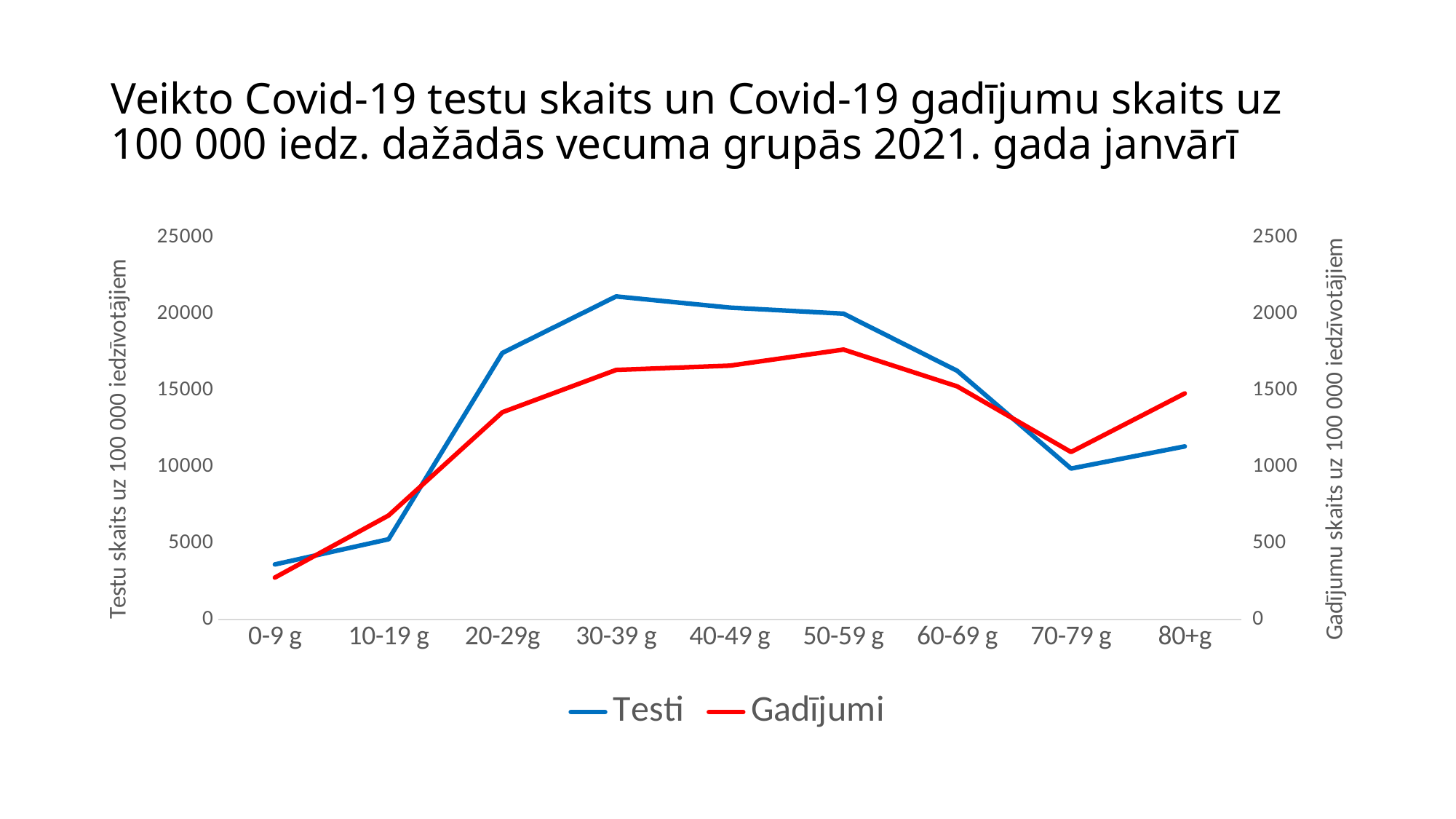
Which is larger, the Gadījumi value for 80+g or for 70-79 g? 80+g Is the Testi value for 30-39 g greater or less than 20000? greater Which age group has the lowest value for Testi? 0-9 g How many age groups are shown on the x axis? 9 Is the Gadījumi value for 0-9 g greater or less than 500? less How many series does the legend list? 2 Is the Testi value for 70-79 g greater or less than 15000? less Which age group has the highest value for Testi? 30-39 g What are the two entries in the legend? Testi and Gadījumi Which age group has the highest value for Gadījumi? 50-59 g Do the Testi values rise or fall from 50-59 g to 70-79 g? fall What kind of chart is shown on the slide? line chart